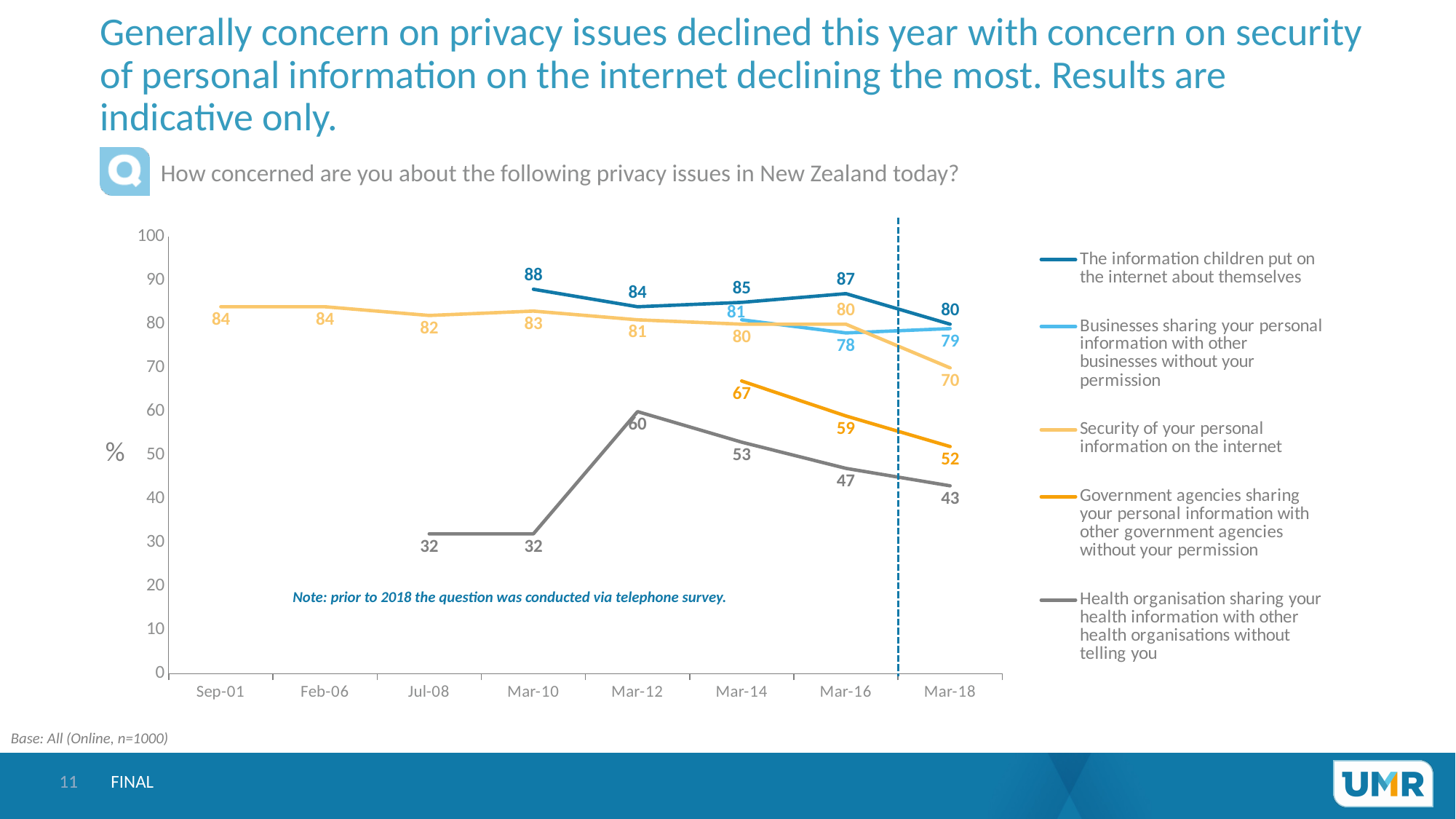
How many time points are shown on the x axis? 8 Which series has the lowest value at Mar-18? Health organisation sharing your health information with other health organisations without telling you What is the value for 'Government agencies sharing your personal information with other government agencies without your permission' at Mar-14? 67 What is the value for 'The information children put on the internet about themselves' at Mar-10? 88 What is the value for 'Health organisation sharing your health information with other health organisations without telling you' at Mar-12? 60 Does the 'Government agencies sharing your personal information with other government agencies without your permission' series rise or fall from Mar-14 to Mar-18? Fall Which series has the highest value at Mar-16? The information children put on the internet about themselves What type of chart is shown on the slide? Line chart What is the difference between the Mar-16 and Mar-18 values for 'Security of your personal information on the internet'? 10 What is the value for 'Security of your personal information on the internet' at Mar-18? 70 How many series does the legend list? 5 At Mar-18, which is larger: the value for 'Businesses sharing your personal information with other businesses without your permission' or the value for 'Government agencies sharing your personal information with other government agencies without your permission'? Businesses sharing your personal information with other businesses without your permission